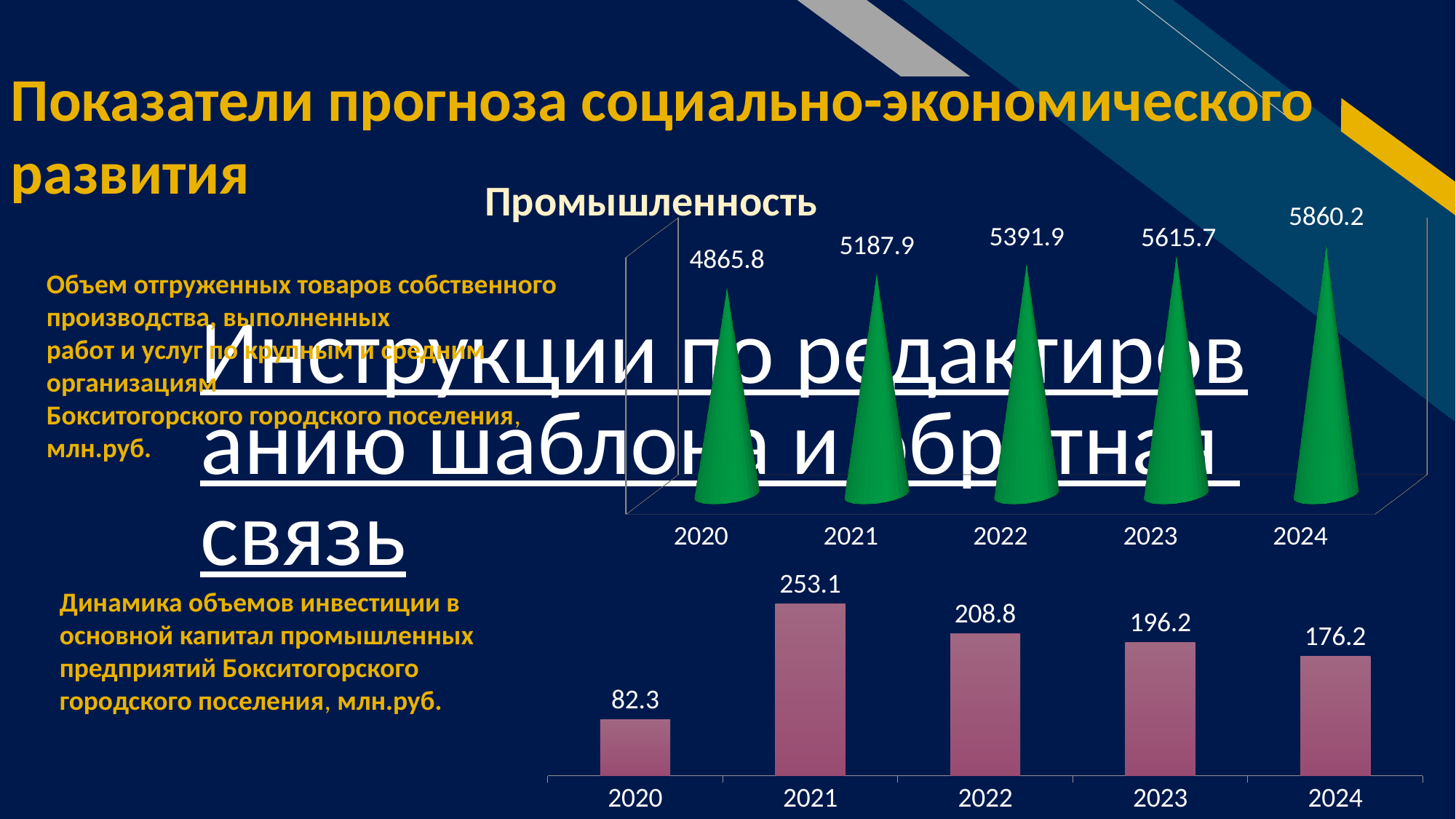
In the top chart titled "Промышленность", what is the value for 2022? 5391.9 In the bottom chart, what is the difference between the 2021 and 2020 values? 170.8 What kind of chart is the bottom chart? bar chart In the bottom chart, which is larger, the value for 2022 or the value for 2024? 2022 In the top chart titled "Промышленность", what is the difference between the 2024 and 2020 values? 994.4 In the top chart titled "Промышленность", which year has the lowest value? 2020 In the top chart titled "Промышленность", do the values rise or fall from 2020 to 2024? rise In the bottom chart, which year has the highest value? 2021 In the bottom chart, what is the value for 2020? 82.3 In the bottom chart, what is the value for 2021? 253.1 In the top chart titled "Промышленность", how many years are plotted? 5 In the top chart titled "Промышленность", what is the value for 2024? 5860.2